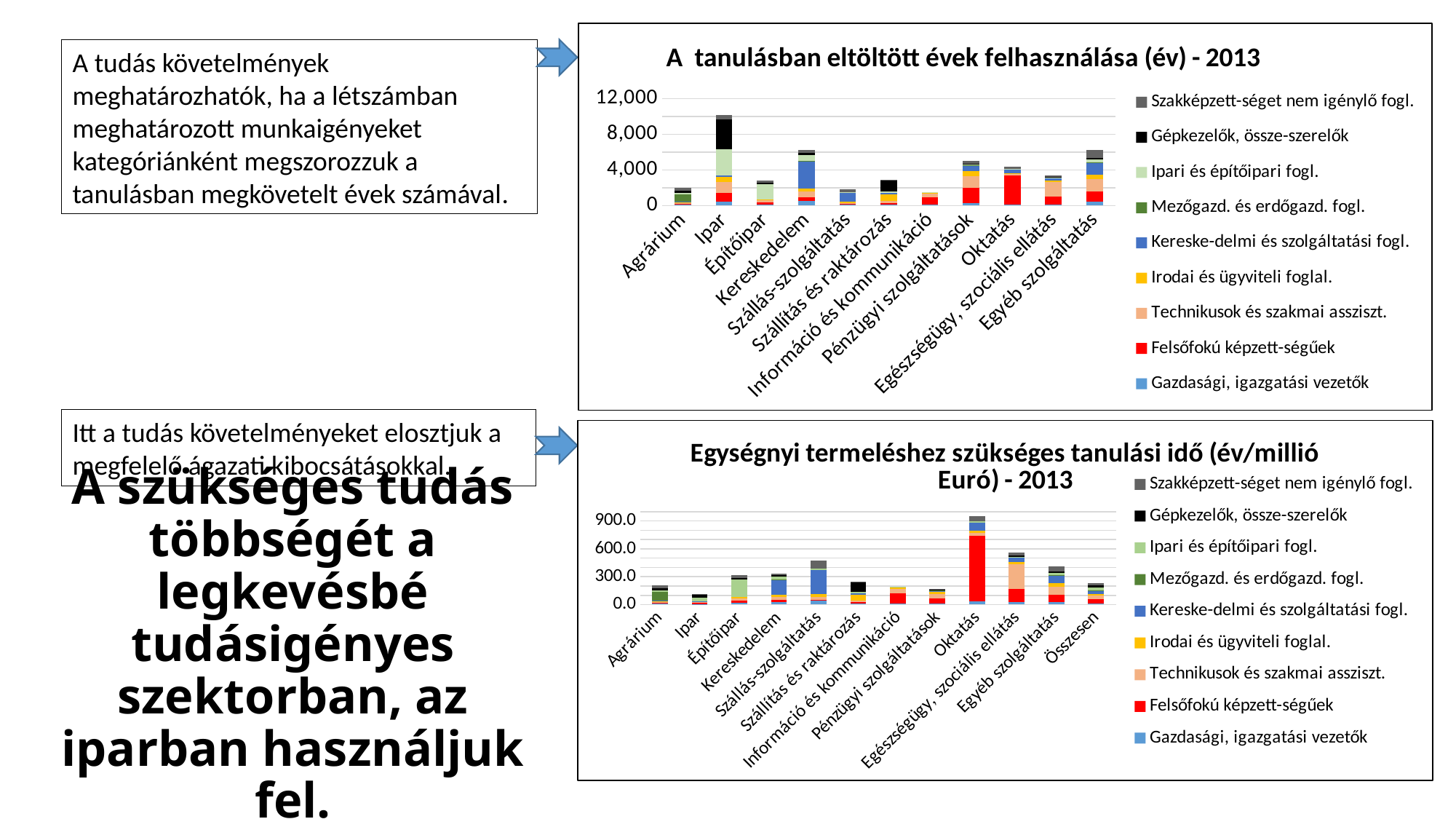
In the bottom chart 'Egységnyi termeléshez szükséges tanulási idő (év/millió Euró) - 2013', which series is shown in red according to the legend? Felsőfokú képzett-ségűek In the bottom chart 'Egységnyi termeléshez szükséges tanulási idő (év/millió Euró) - 2013', which category has the tallest stacked bar? Oktatás In the top chart 'A tanulásban eltöltött évek felhasználása (év) - 2013', is the total for Kereskedelem greater or less than 4,000? greater In the bottom chart 'Egységnyi termeléshez szükséges tanulási idő (év/millió Euró) - 2013', which category has the shortest stacked bar? Ipar How many categories are shown on the x axis of the top chart 'A tanulásban eltöltött évek felhasználása (év) - 2013'? 11 How many categories are shown on the x axis of the bottom chart 'Egységnyi termeléshez szükséges tanulási idő (év/millió Euró) - 2013'? 12 In the bottom chart 'Egységnyi termeléshez szükséges tanulási idő (év/millió Euró) - 2013', is the total for Oktatás greater or less than 600.0? greater In the bottom chart 'Egységnyi termeléshez szükséges tanulási idő (év/millió Euró) - 2013', is the total for Ipar greater or less than 300.0? less What type of chart is the top chart, 'A tanulásban eltöltött évek felhasználása (év) - 2013'? stacked bar chart How many series does the legend of the top chart 'A tanulásban eltöltött évek felhasználása (év) - 2013' list? 9 In the top chart 'A tanulásban eltöltött évek felhasználása (év) - 2013', which category has the tallest stacked bar? Ipar